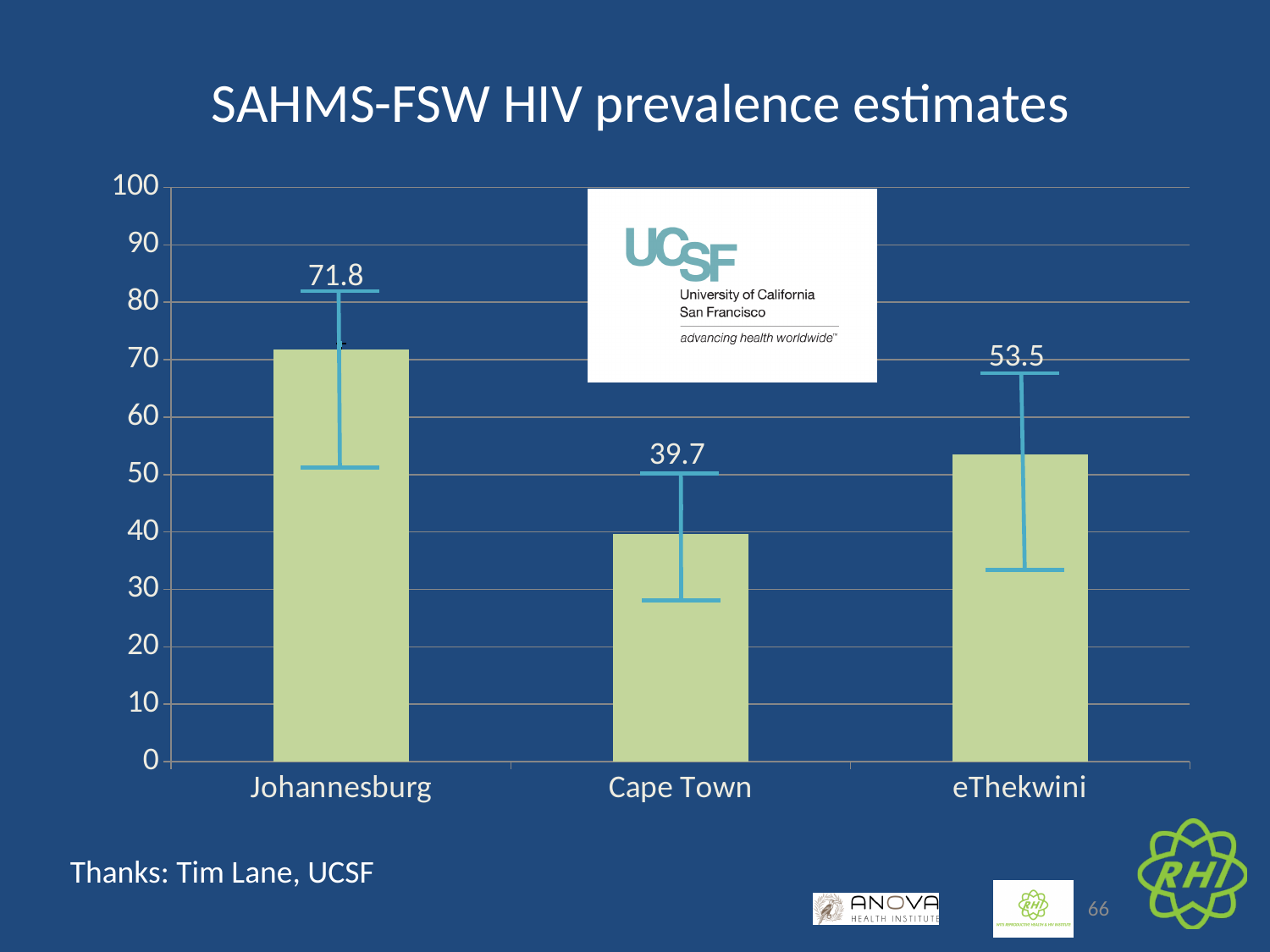
Is the value for Johannesburg greater or less than 70? greater What is the title of the chart? SAHMS-FSW HIV prevalence estimates What is the difference between the Johannesburg and Cape Town estimates? 32.1 Which is larger, the estimate for eThekwini or for Cape Town? eThekwini What is the difference between the eThekwini and Cape Town estimates? 13.8 What is the HIV prevalence estimate for eThekwini? 53.5 How many cities are shown on the chart? 3 Which city has the lowest HIV prevalence estimate? Cape Town What is the HIV prevalence estimate for Johannesburg? 71.8 What kind of chart is shown on the slide? Bar chart Which city has the highest HIV prevalence estimate? Johannesburg What is the HIV prevalence estimate for Cape Town? 39.7